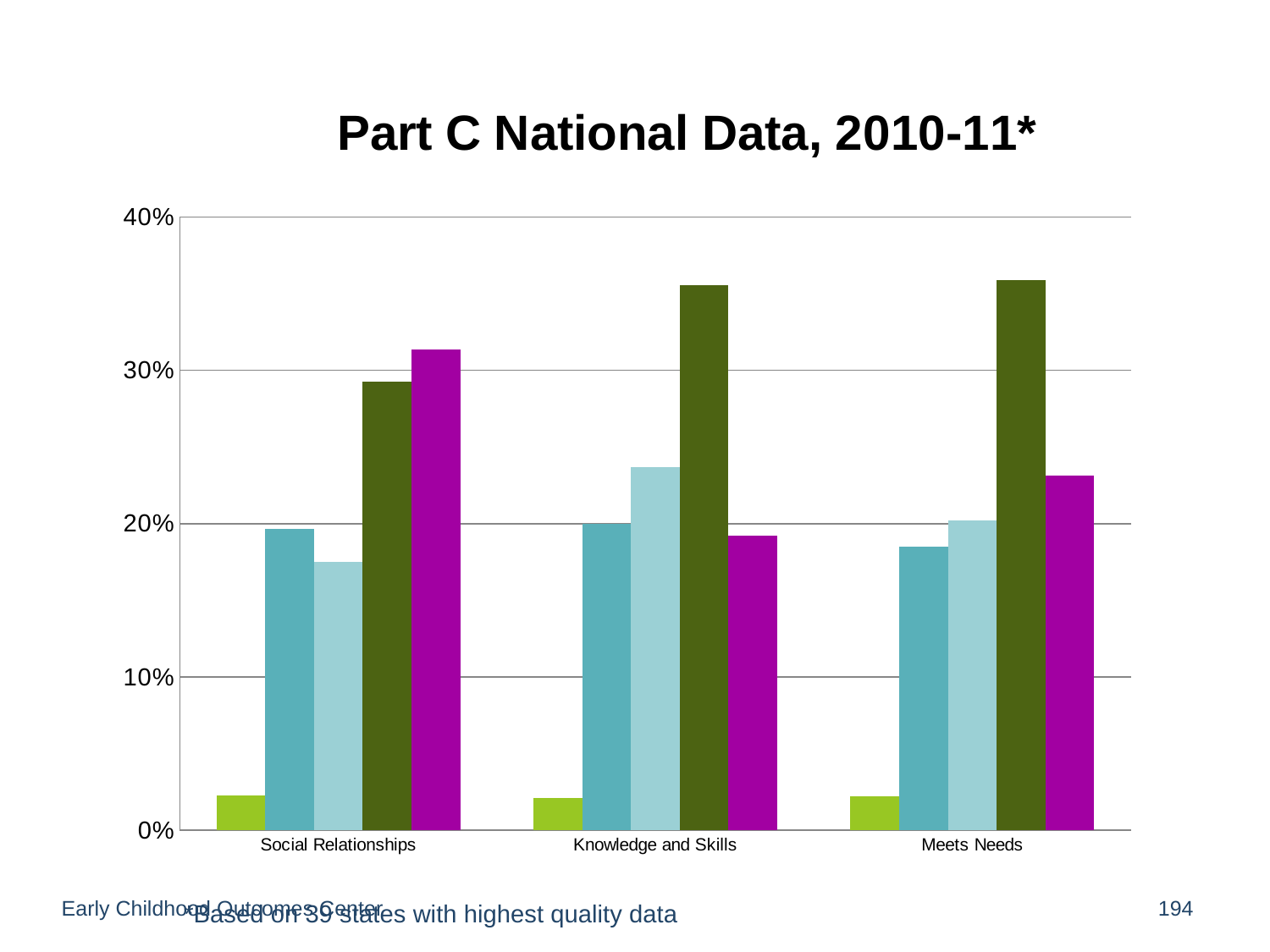
Which bar is the shortest in the Meets Needs category? the light green bar Is the value of the dark green bar for Meets Needs greater or less than 30%? greater Is the value of the light green bar for Knowledge and Skills greater or less than 10%? less How many bars are plotted for each category? 5 Which bar is the tallest in the Social Relationships category? the purple bar Which is larger: the purple bar for Social Relationships or the purple bar for Meets Needs? Social Relationships What kind of chart is shown on the slide? bar chart Which bar is the tallest in the Knowledge and Skills category? the dark green bar How many categories are shown on the x axis? 3 Is the value of the purple bar for Social Relationships greater or less than 30%? greater What is the title of the chart? Part C National Data, 2010-11*